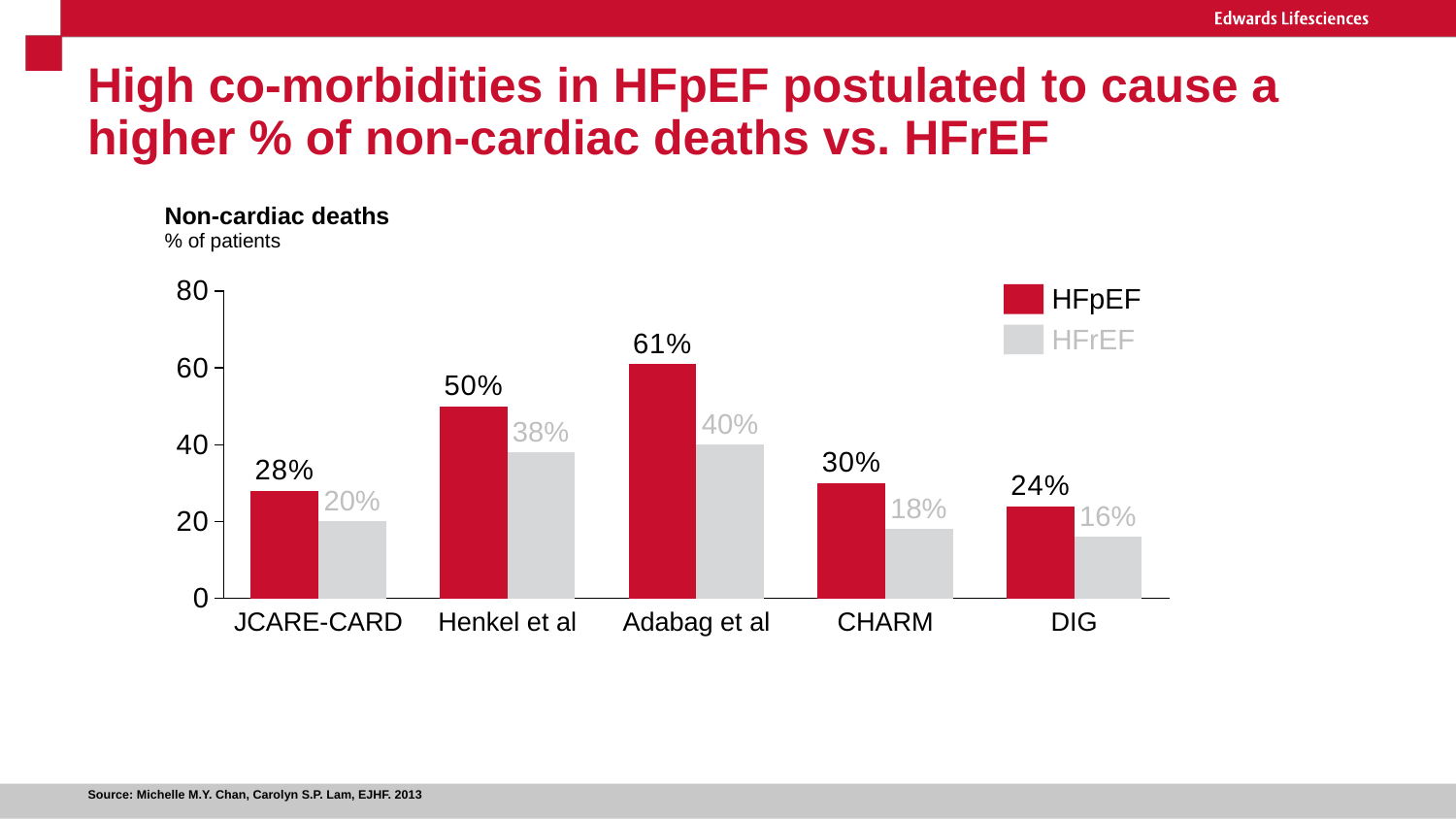
What is the HFpEF value for Adabag et al? 61% What is the difference between the HFpEF and HFrEF values for Henkel et al? 12% Which study has the highest HFpEF value? Adabag et al What is the title of the chart? Non-cardiac deaths What is the HFpEF value for DIG? 24% Is the HFrEF value for Adabag et al greater or less than 60? less What kind of chart is shown? Bar chart Which study has the lowest HFrEF value? DIG What is the HFrEF value for CHARM? 18% Which is larger for JCARE-CARD, the HFpEF value or the HFrEF value? HFpEF How many studies are shown on the x axis? 5 How many series does the legend list? 2